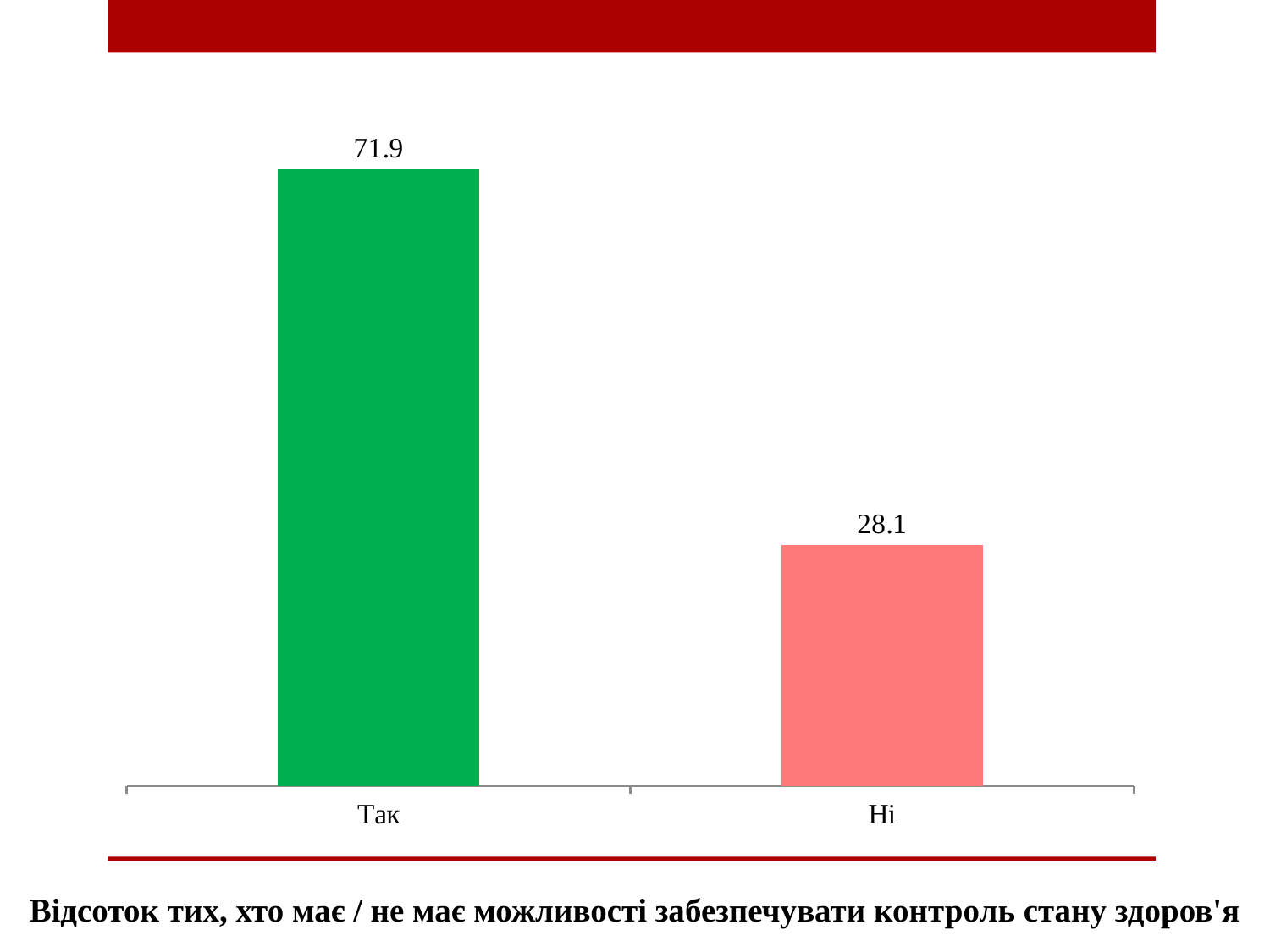
What kind of chart is shown on the slide? Bar chart What is the total of the two values shown on the chart? 100 Which category has the lowest value? Ні What is the value for "Ні"? 28.1 What is the value for "Так"? 71.9 What colour is the bar for "Так"? Green What is the difference between the values for "Так" and "Ні"? 43.8 Which is larger, the value for "Так" or the value for "Ні"? Так How many categories are shown on the chart? 2 What is the caption text below the chart? Відсоток тих, хто має / не має можливості забезпечувати контроль стану здоров'я Which category has the highest value? Так